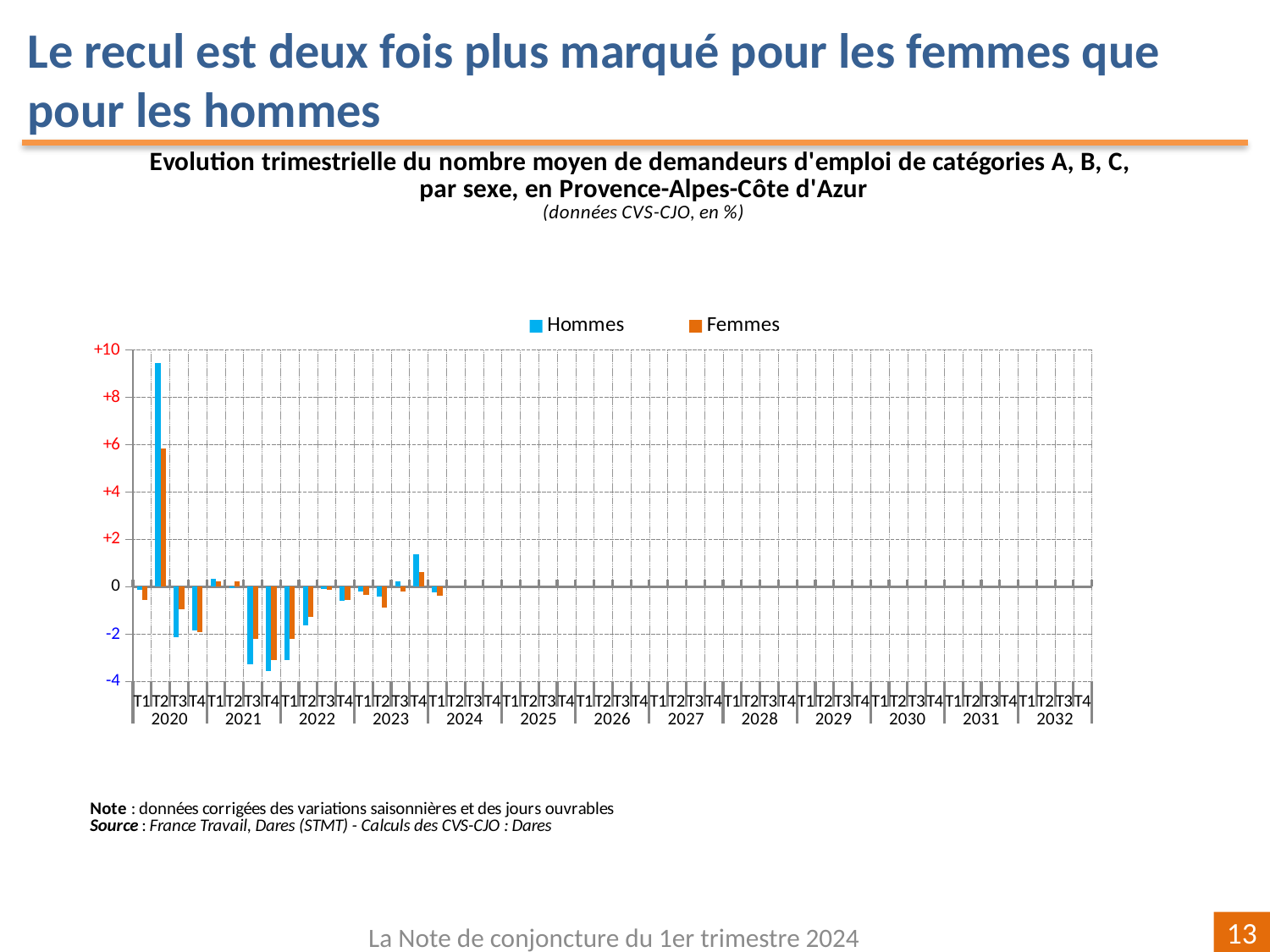
Which series is shown in orange? Femmes How many series does the legend list? 2 How many years are labelled along the x axis? 13 Is the Hommes value for T2 2020 greater or less than +8? greater In T2 2020, which series has the larger value, Hommes or Femmes? Hommes Is the Hommes value for T3 2021 greater or less than -2? less In T1 2022, which series has the lower value, Hommes or Femmes? Hommes What are the two series named in the legend? Hommes and Femmes What kind of chart is shown on the slide? bar chart Is the Femmes value for T4 2020 greater or less than 0? less In which quarter does the Hommes series reach its highest value? T2 2020